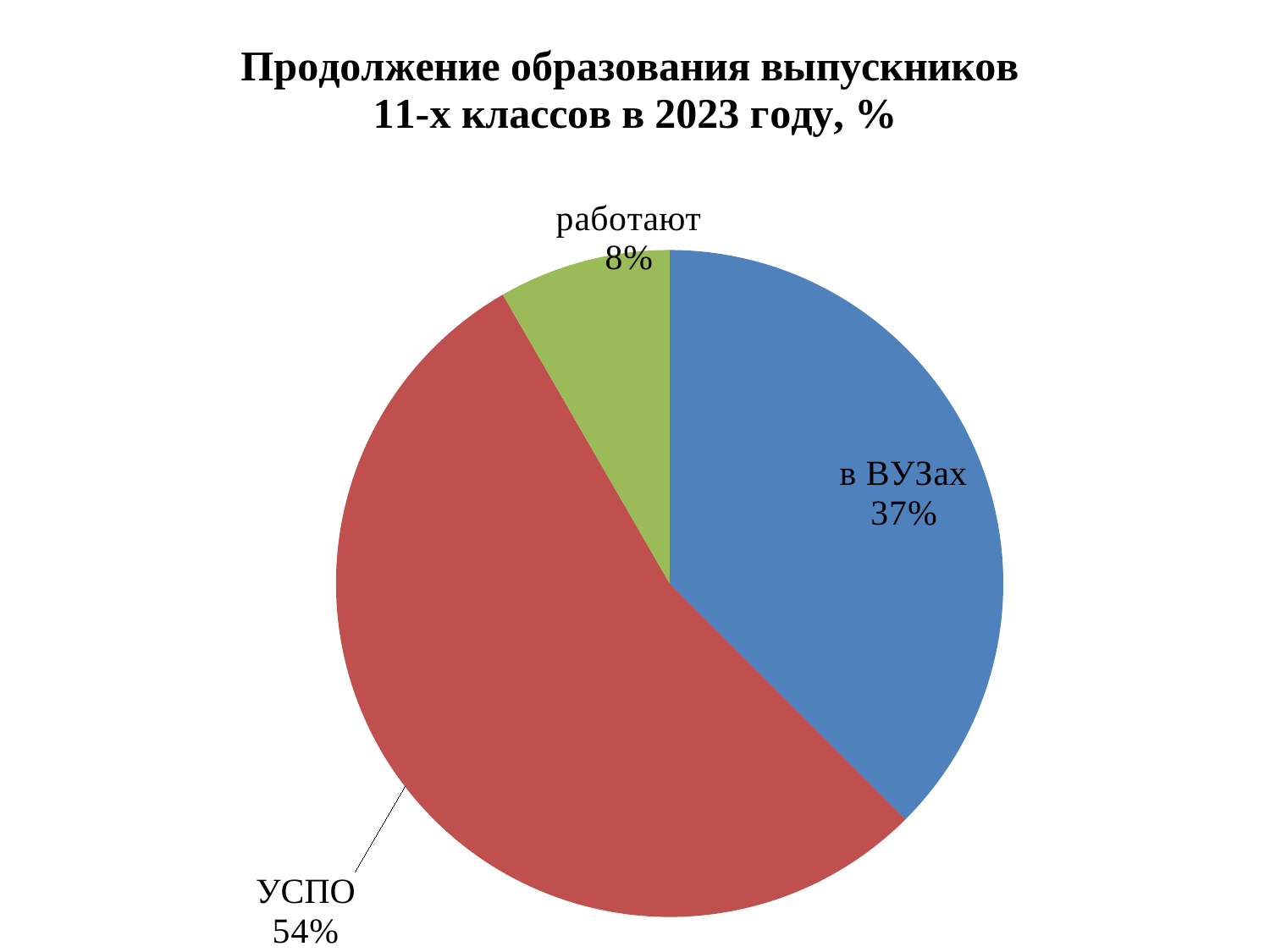
What share of graduates is shown for "УСПО"? 54% How many slices does the pie chart have? 3 What share of graduates is shown for "в ВУЗах"? 37% What is the difference in percentage points between "УСПО" and "в ВУЗах"? 17 What is the title of the chart? Продолжение образования выпускников 11-х классов в 2023 году, % Which is larger, the share for "в ВУЗах" or the share for "работают"? в ВУЗах What share of graduates is shown for "работают"? 8% What is the difference in percentage points between "в ВУЗах" and "работают"? 29 Which category has the smallest slice of the pie? работают Which category has the largest slice of the pie? УСПО What colour is the slice for "УСПО"? red What type of chart is shown on the slide? pie chart